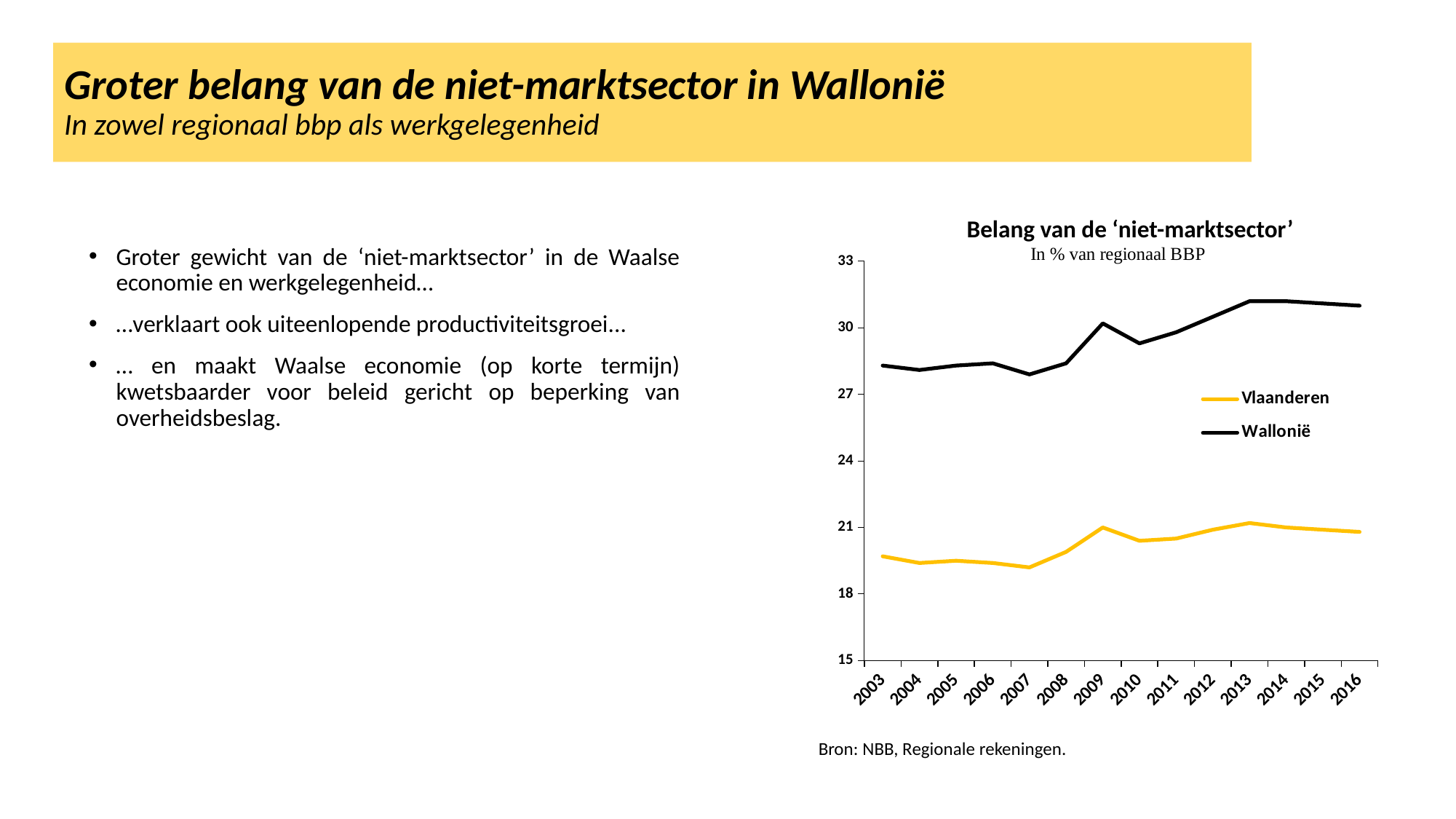
What kind of chart is shown on the slide? line chart Which series has the larger value in 2010, Vlaanderen or Wallonië? Wallonië Which colour is used for the Vlaanderen line? yellow In which year is the value for Wallonië lowest? 2007 What is the title of the chart? Belang van de ‘niet-marktsector’ How many series does the legend of the chart list? 2 Does the value for Wallonië rise or fall overall from 2003 to 2016? rise Is the value for Vlaanderen in 2003 greater or less than 21? less How many years are shown on the x axis of the chart? 14 In which year is the value for Vlaanderen lowest? 2007 Is the value for Wallonië in 2007 greater or less than 30? less